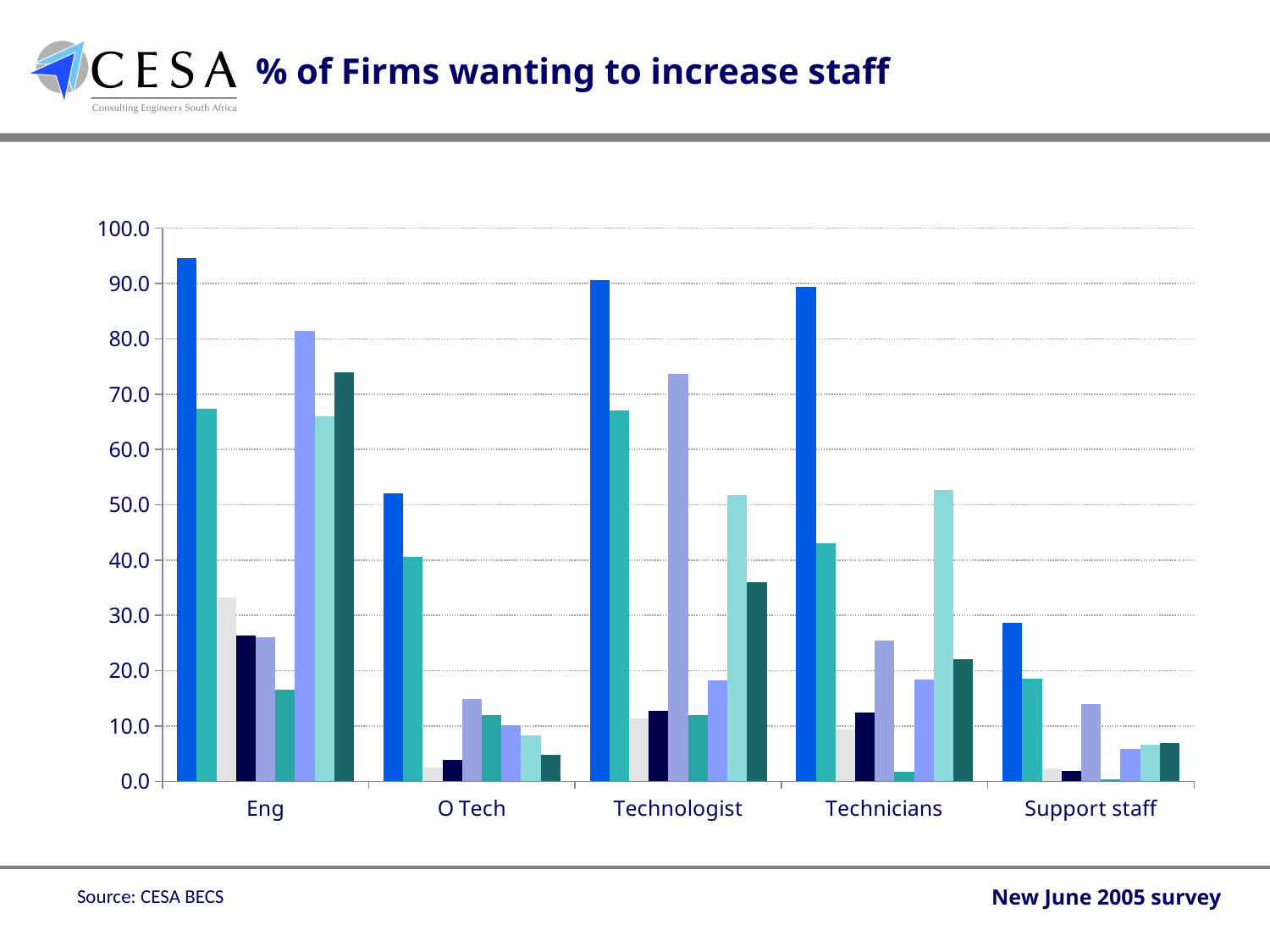
What is the title of the chart? % of Firms wanting to increase staff What source is cited for the chart? CESA BECS Is the value of the leftmost bar in the Eng group greater or less than 90? greater Which category has the lowest leftmost bar? Support staff What kind of chart is shown on the slide? bar chart How many bars are plotted for each staff category? 9 Is the value of the leftmost bar in the Technicians group greater or less than 80? greater Is the value of the leftmost bar in the Support staff group greater or less than 40? less Which category contains the tallest bar on the chart? Eng How many staff categories are shown along the x axis? 5 Which is larger: the leftmost bar for Eng or the leftmost bar for Support staff? Eng